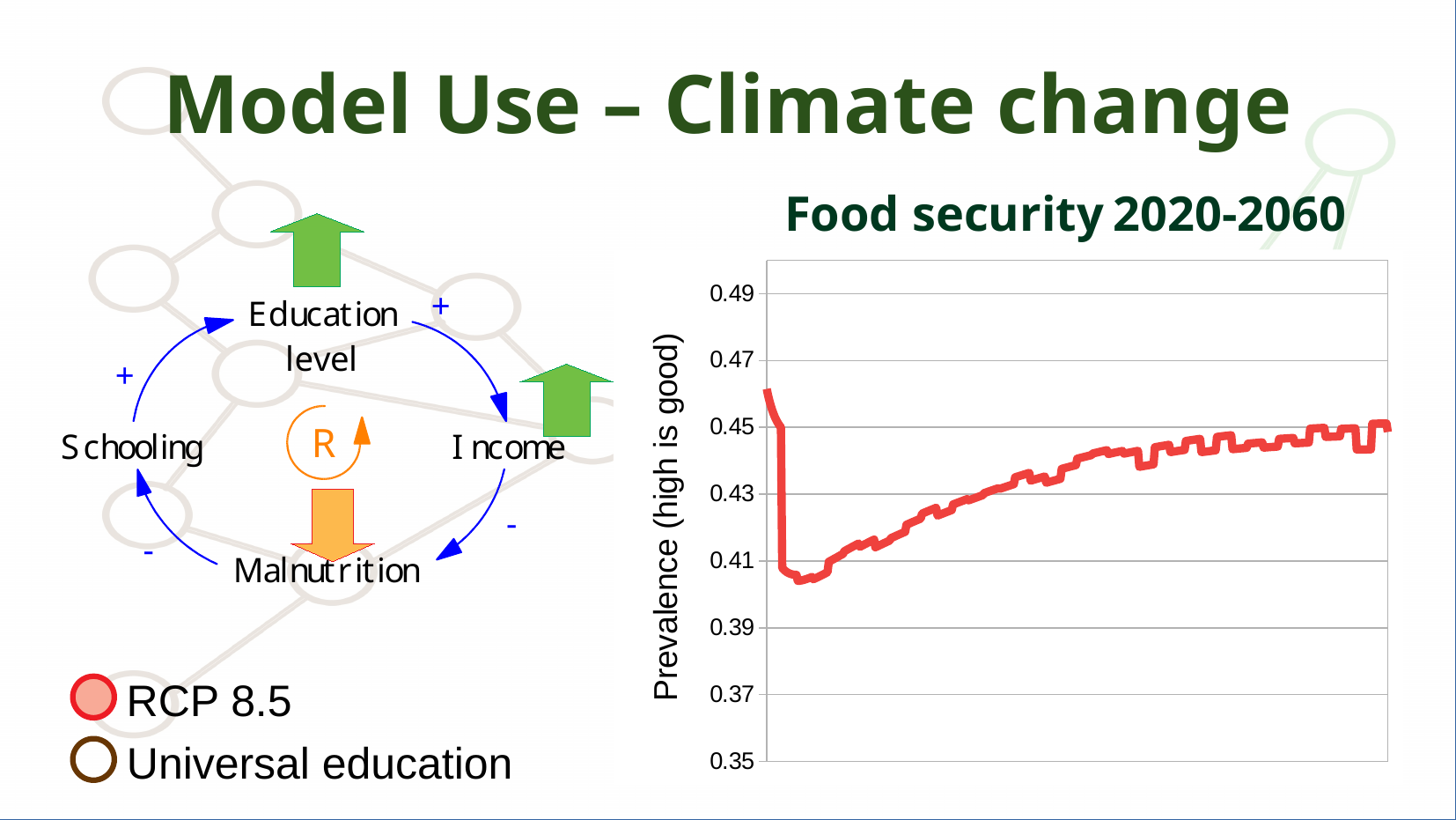
In the "Food security 2020-2060" chart, is the value at the very start of the red line greater or less than 0.45? greater In the "Food security 2020-2060" chart, is the lowest point of the red line greater or less than 0.41? less What is the title of the chart on the right of the slide? Food security 2020-2060 In the "Food security 2020-2060" chart, is the value at the right end of the red line greater or less than 0.43? greater What is the label of the vertical axis of the "Food security 2020-2060" chart? Prevalence (high is good) What kind of chart is shown under the title "Food security 2020-2060"? line chart What is the highest tick value shown on the vertical axis of the "Food security 2020-2060" chart? 0.49 In the "Food security 2020-2060" chart, after its initial sharp drop, does the red line generally rise or fall along the x axis? rise In the "Food security 2020-2060" chart, is the value at the right end of the red line greater or less than the value at its lowest point? greater How many lines are plotted in the "Food security 2020-2060" chart? 1